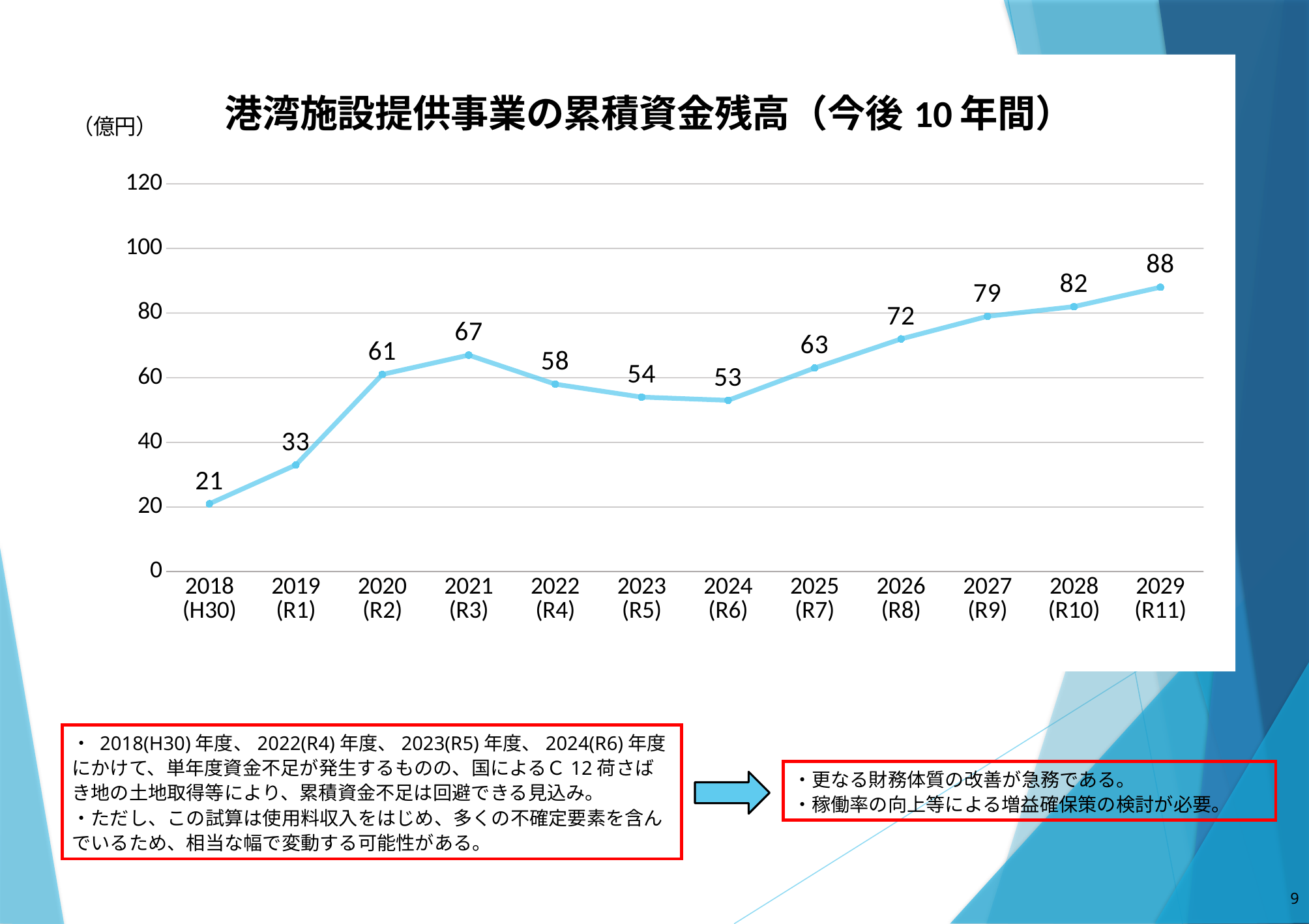
What kind of chart is shown on the slide? line chart What is the value for 2024 (R6)? 53 Which is larger, the value for 2020 (R2) or the value for 2022 (R4)? 2020 (R2) Which year has the highest value? 2029 (R11) What is the value for 2021 (R3)? 67 What is the difference between the values for 2021 (R3) and 2024 (R6)? 14 Is the value for 2027 (R9) greater or less than 80? less Do the values rise or fall from 2024 (R6) to 2029 (R11)? rise What is the difference between the values for 2029 (R11) and 2018 (H30)? 67 What is the value for 2018 (H30)? 21 How many years are plotted on the chart? 12 Which year has the lowest value? 2018 (H30)